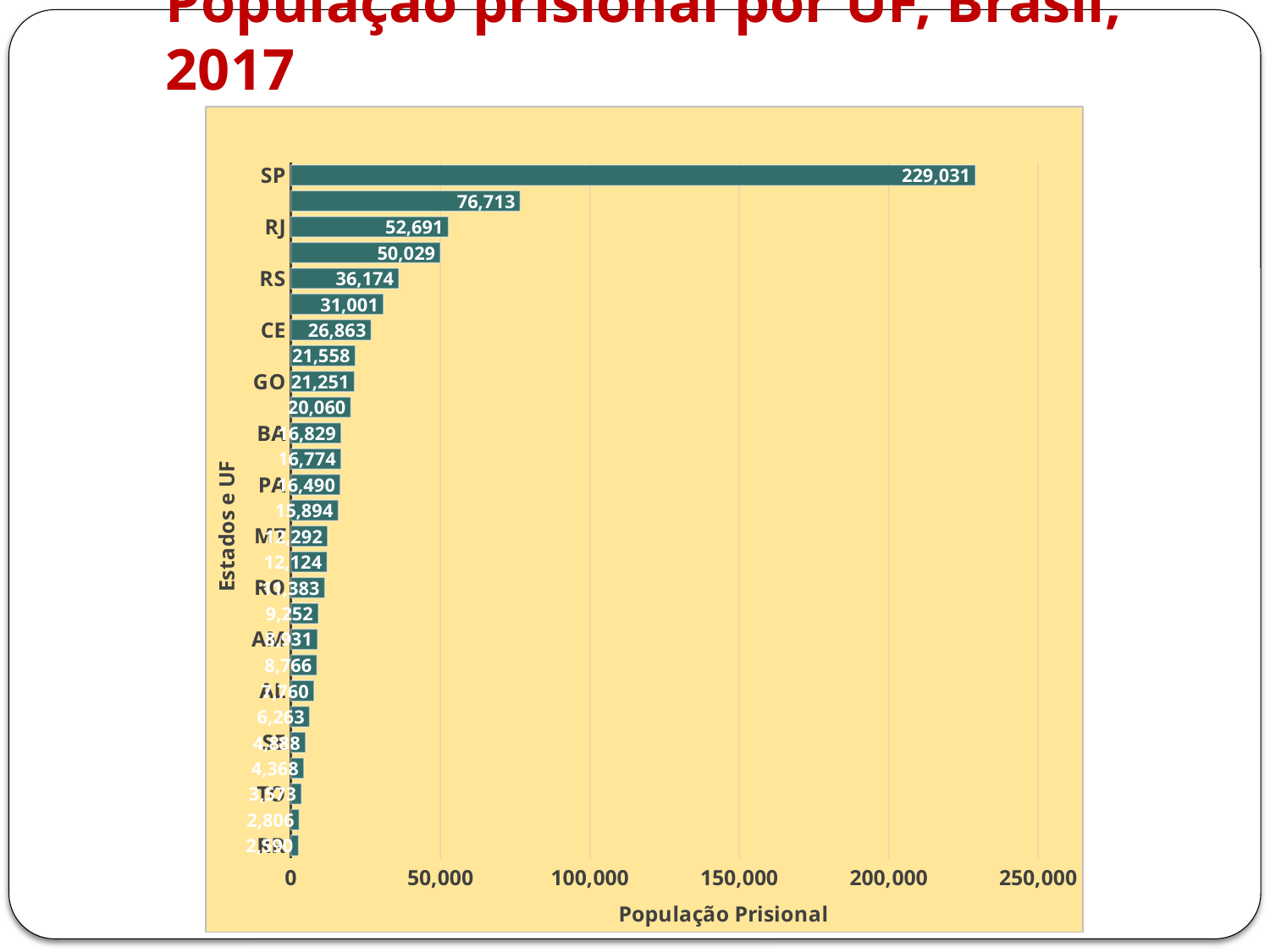
Which has a larger prison population, RJ or RS? RJ What is the label of the horizontal axis of the chart? População Prisional Is the value for SP greater or less than 200,000? greater What is the prison population shown for SP? 229,031 What is the prison population shown for RJ? 52,691 What kind of chart is shown on the slide? Bar chart What is the difference between the prison populations of SP and RJ? 176,340 What is the prison population shown for GO? 21,251 What is the difference between the prison populations of RS and CE? 9,311 What is the prison population shown for CE? 26,863 What is the prison population shown for RS? 36,174 Which state has the highest prison population in the chart? SP